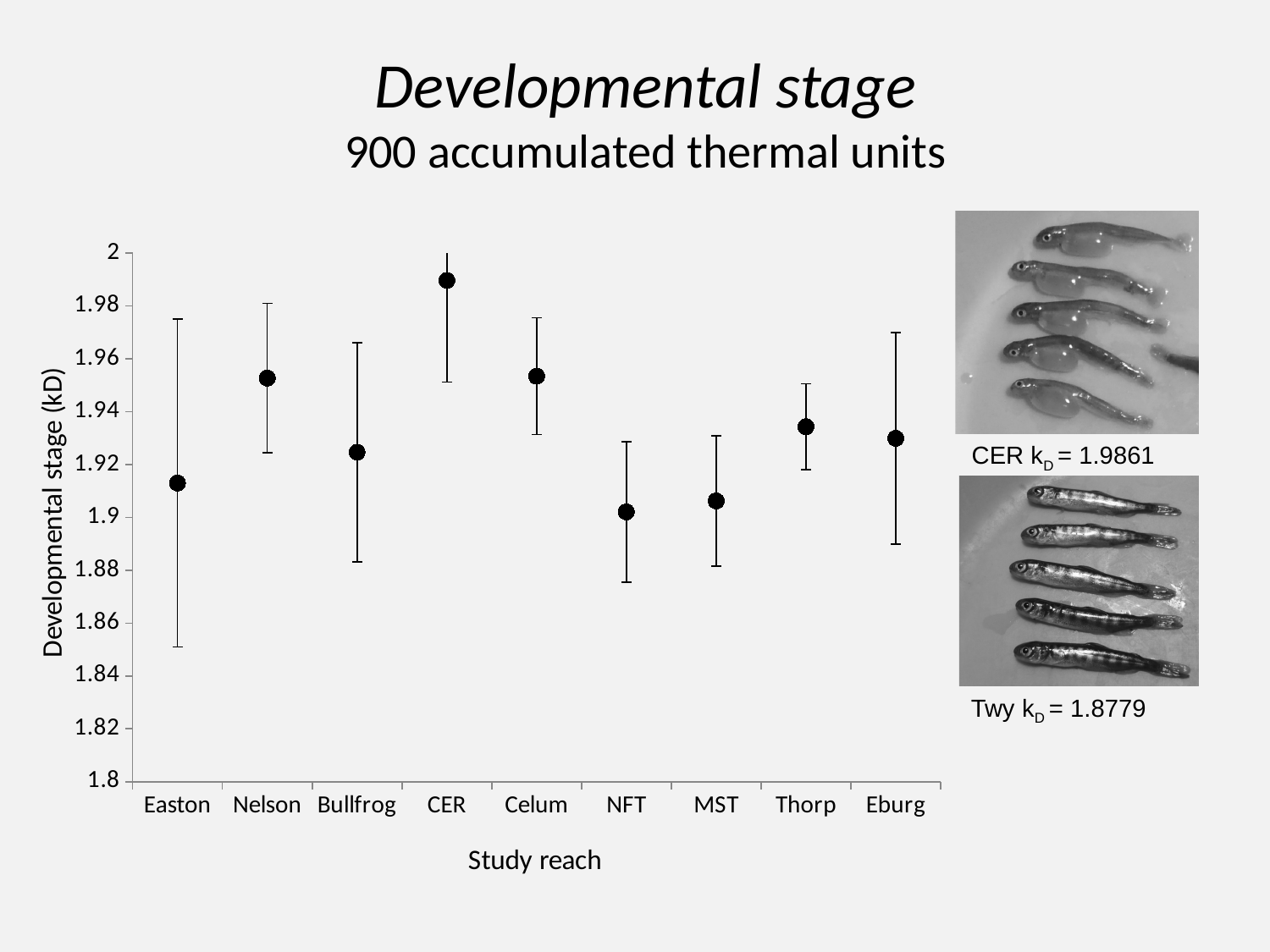
Is the value for CER greater or less than 1.98? greater What is the label of the x axis of the chart? Study reach Is the value for Nelson greater or less than 1.94? greater Is the value for Easton greater or less than 1.92? less Which has the larger developmental stage value, Nelson or NFT? Nelson Which study reach has the highest developmental stage value? CER How many study reaches are plotted on the x axis? 9 What kind of chart is shown on the slide? Scatter (dot) plot with error bars Which has the larger developmental stage value, CER or Easton? CER